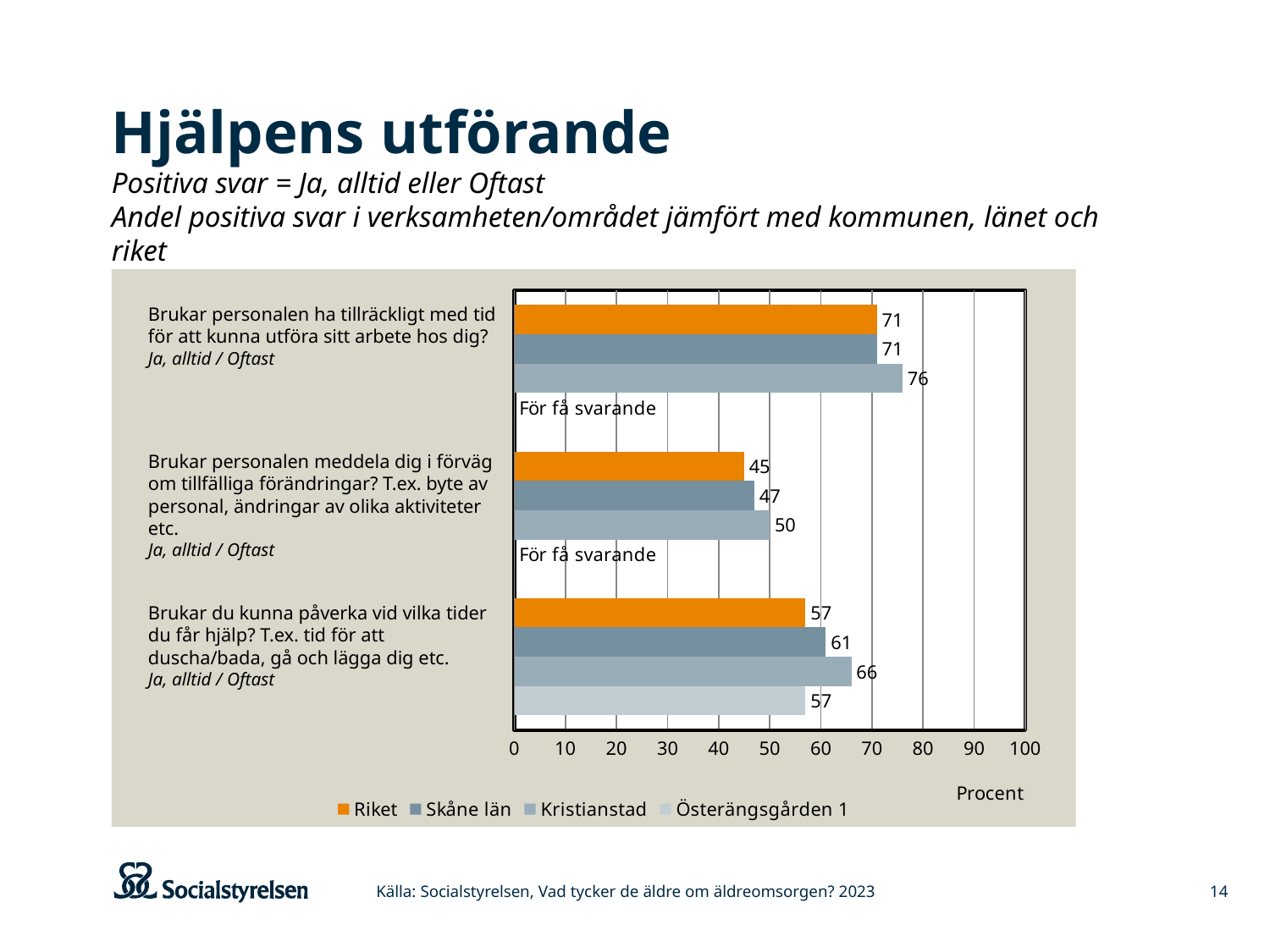
What is the value for Riket for the question 'Brukar personalen meddela dig i förväg om tillfälliga förändringar?' 45 What is shown for Österängsgården 1 for the question 'Brukar personalen ha tillräckligt med tid för att kunna utföra sitt arbete hos dig?' För få svarande What is the difference between Kristianstad and Riket for the question 'Brukar personalen meddela dig i förväg om tillfälliga förändringar?' 5 What unit is shown on the x axis of the chart? Procent How many series does the legend list? 4 What type of chart is shown on the slide? bar chart What is the value for Österängsgården 1 for the question 'Brukar du kunna påverka vid vilka tider du får hjälp?' 57 Which is larger for the question 'Brukar du kunna påverka vid vilka tider du får hjälp?': Kristianstad or Riket? Kristianstad Which series has the highest value for the question 'Brukar du kunna påverka vid vilka tider du får hjälp?' Kristianstad What is the value for Kristianstad for the question 'Brukar personalen ha tillräckligt med tid för att kunna utföra sitt arbete hos dig?' 76 How many questions (categories) are shown on the chart? 3 What is the value for Skåne län for the question 'Brukar du kunna påverka vid vilka tider du får hjälp?' 61